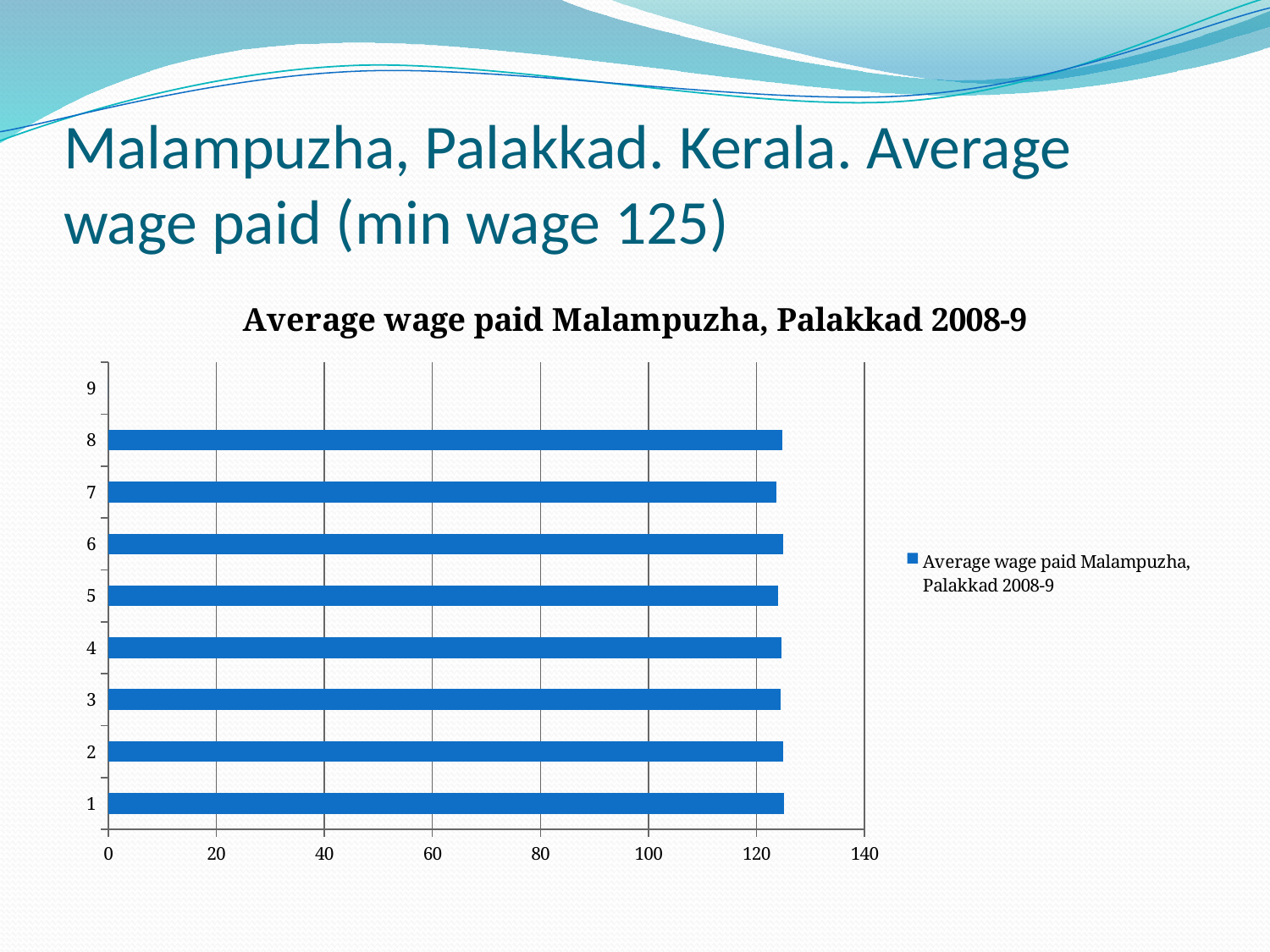
Is the value for category 7 greater or less than 80? greater How many series does the legend list? 1 Is the value for category 4 greater or less than 120? greater How many bars are plotted in the chart? 8 What is the title of the chart? Average wage paid Malampuzha, Palakkad 2008-9 How many categories are labelled on the vertical axis? 9 What kind of chart is shown on the slide? bar chart What is the highest value shown on the horizontal axis? 140 Is the value for category 1 greater or less than 100? greater